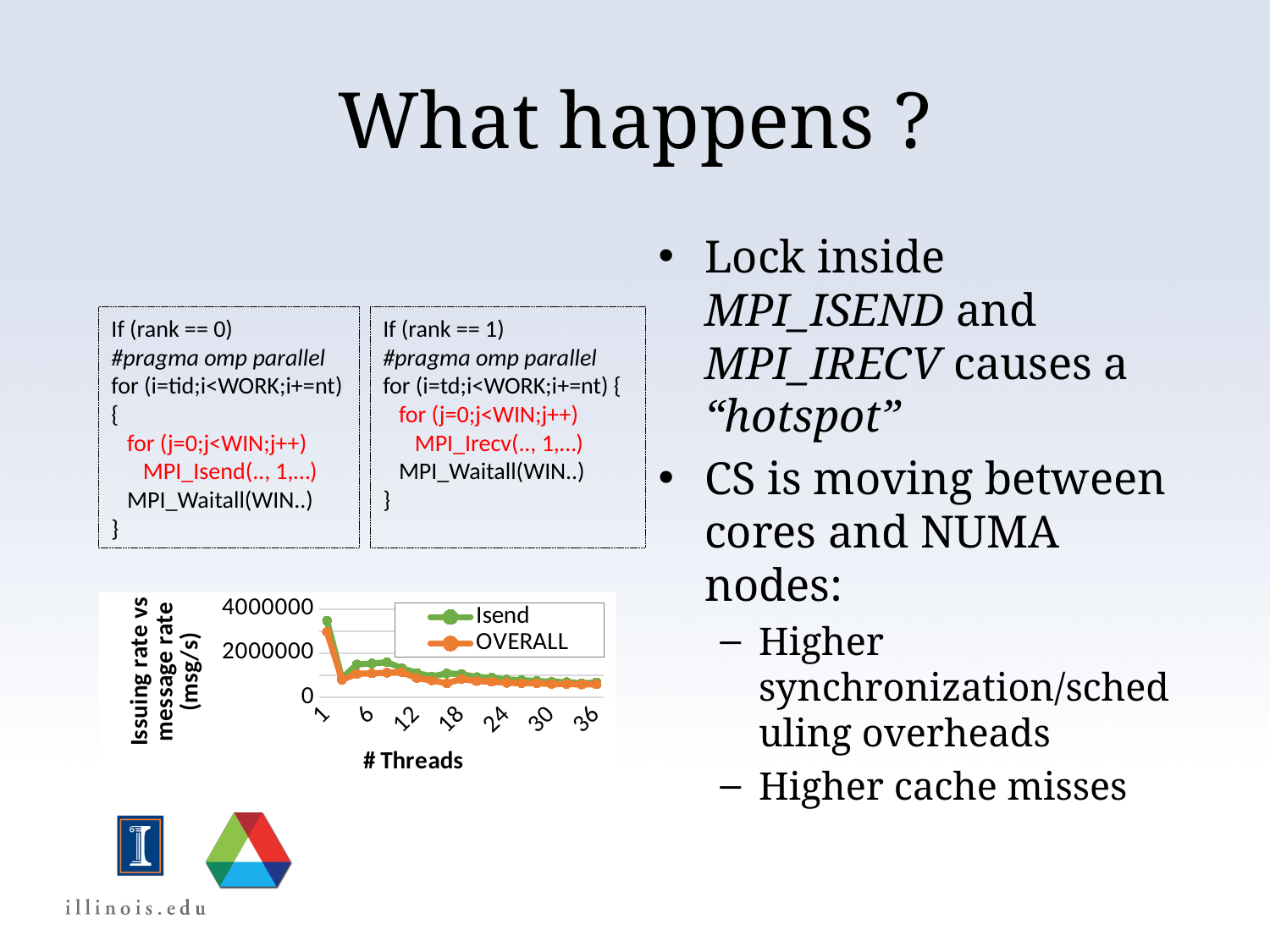
What kind of chart is shown on the slide? line chart Is the value of the OVERALL series at 1 thread greater or less than 2000000? greater What is the label of the chart's x axis? # Threads Do the values of the OVERALL series rise or fall as the number of threads increases along the x axis? fall Do the values of the Isend series rise or fall as the number of threads increases along the x axis? fall Is the value of the Isend series at 36 threads greater or less than 2000000? less Is the value of the OVERALL series at 24 threads greater or less than 2000000? less How many series does the chart's legend list? 2 What are the two series named in the chart's legend? Isend and OVERALL At 1 thread, which series has the larger value, Isend or OVERALL? Isend At 12 threads, which series has the larger value, Isend or OVERALL? Isend